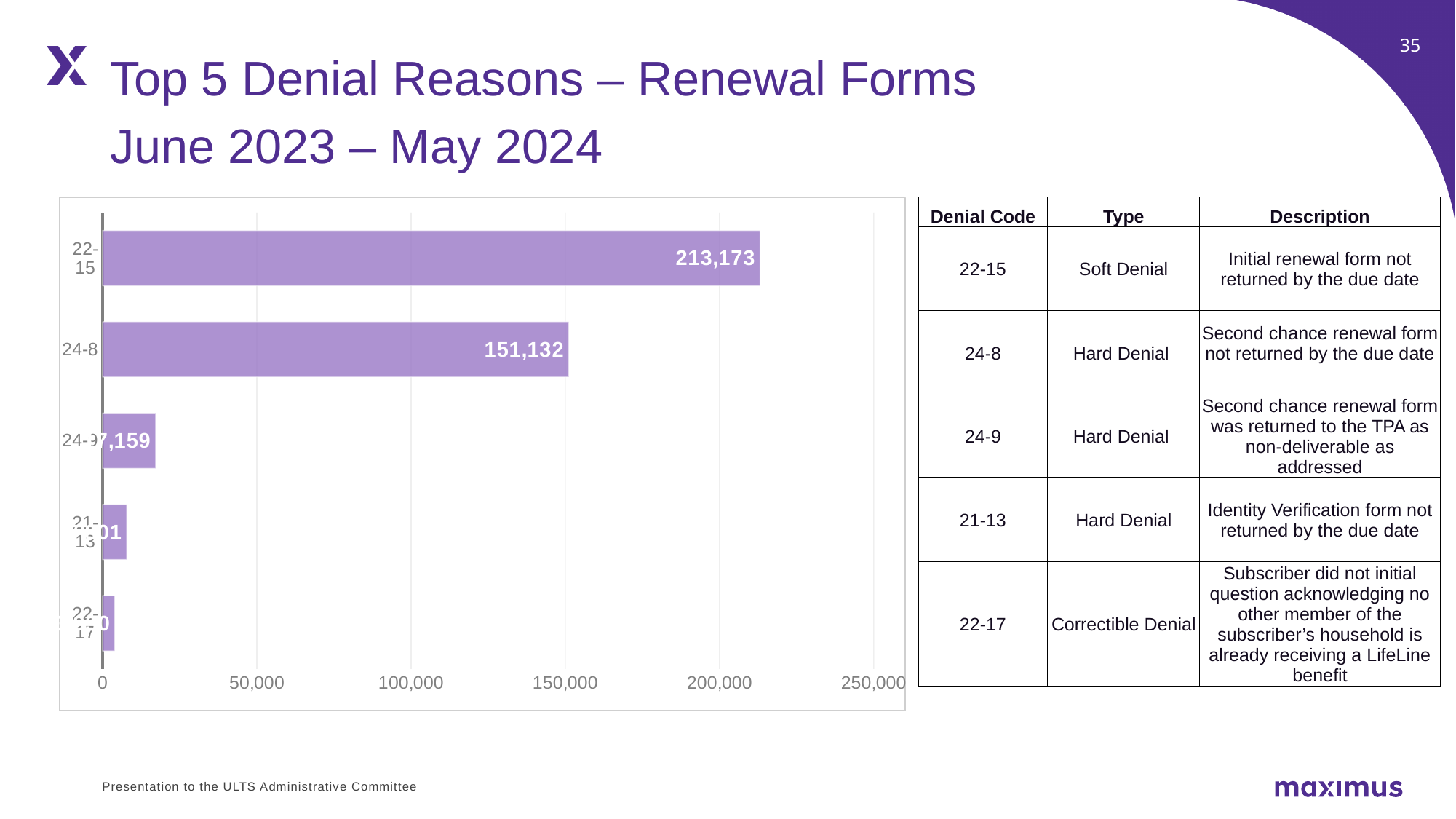
Is the value for 22-15 greater or less than 200,000? greater What is the value for denial code 22-15? 213,173 What kind of chart is shown on the slide? bar chart Which denial code has the highest value in the chart? 22-15 Is the value for 24-9 greater or less than 50,000? less Which denial code has the lowest value in the chart? 22-17 What is the value for denial code 24-8? 151,132 What is the difference between the values for 22-15 and 24-8? 62,041 Is the value for 24-8 greater or less than 150,000? greater Which has a larger value, 24-8 or 24-9? 24-8 How many denial codes are plotted in the chart? 5 What is the highest value shown on the chart's horizontal axis? 250,000